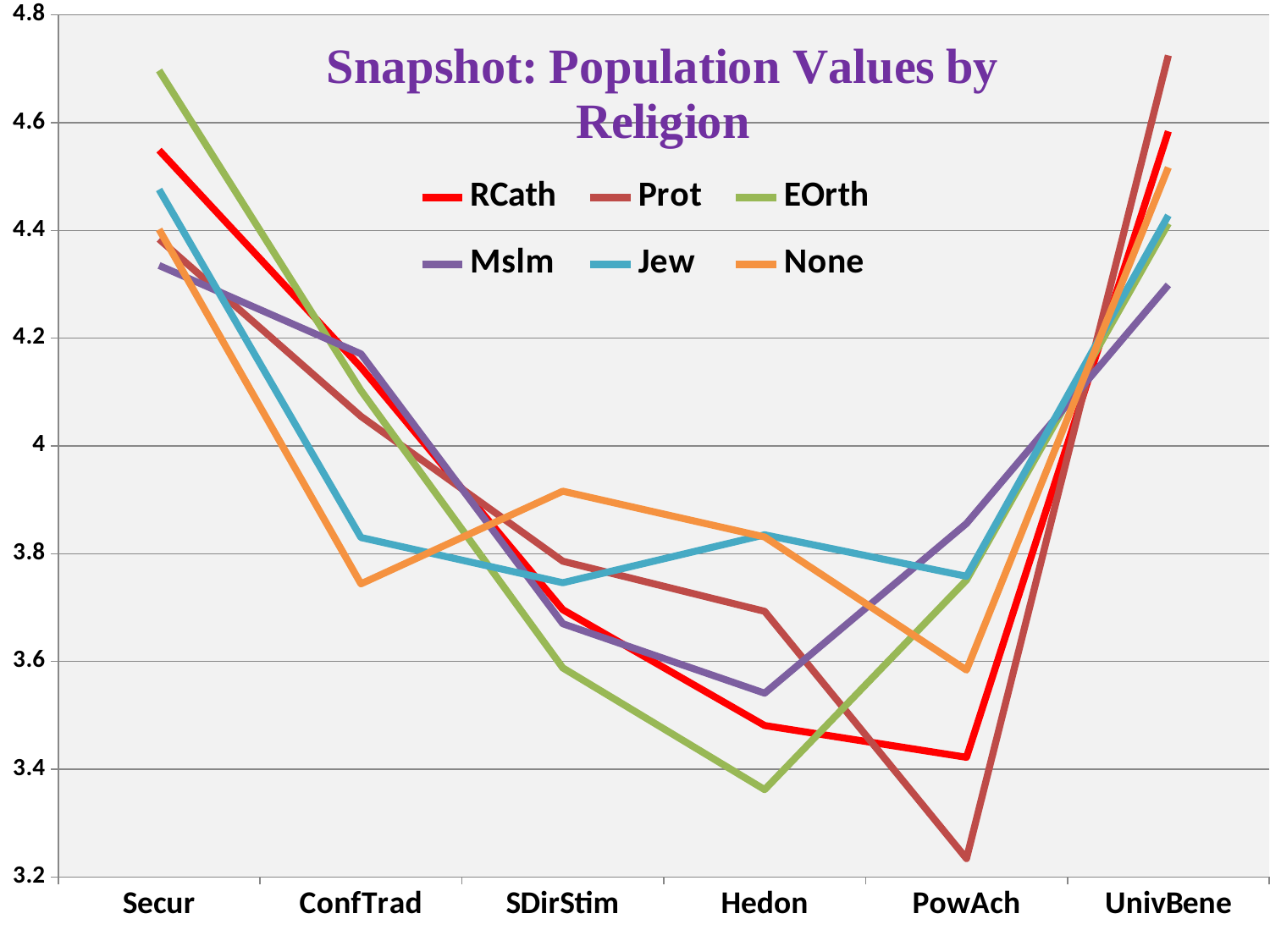
How many categories are shown along the x axis? 6 Is the value for EOrth at Hedon greater or less than 3.4? less What kind of chart is shown on the slide? line chart Which series has the lowest value at Hedon? EOrth At Hedon, which is larger: the value for Jew or the value for RCath? Jew How many series does the legend list? 6 Is the value for None at SDirStim greater or less than 3.8? greater What is the title of the chart? Snapshot: Population Values by Religion Which series has the highest value at UnivBene? Prot Which series has the lowest value at PowAch? Prot Which series has the highest value at Secur? EOrth Does the RCath line rise or fall from Secur to PowAch? fall